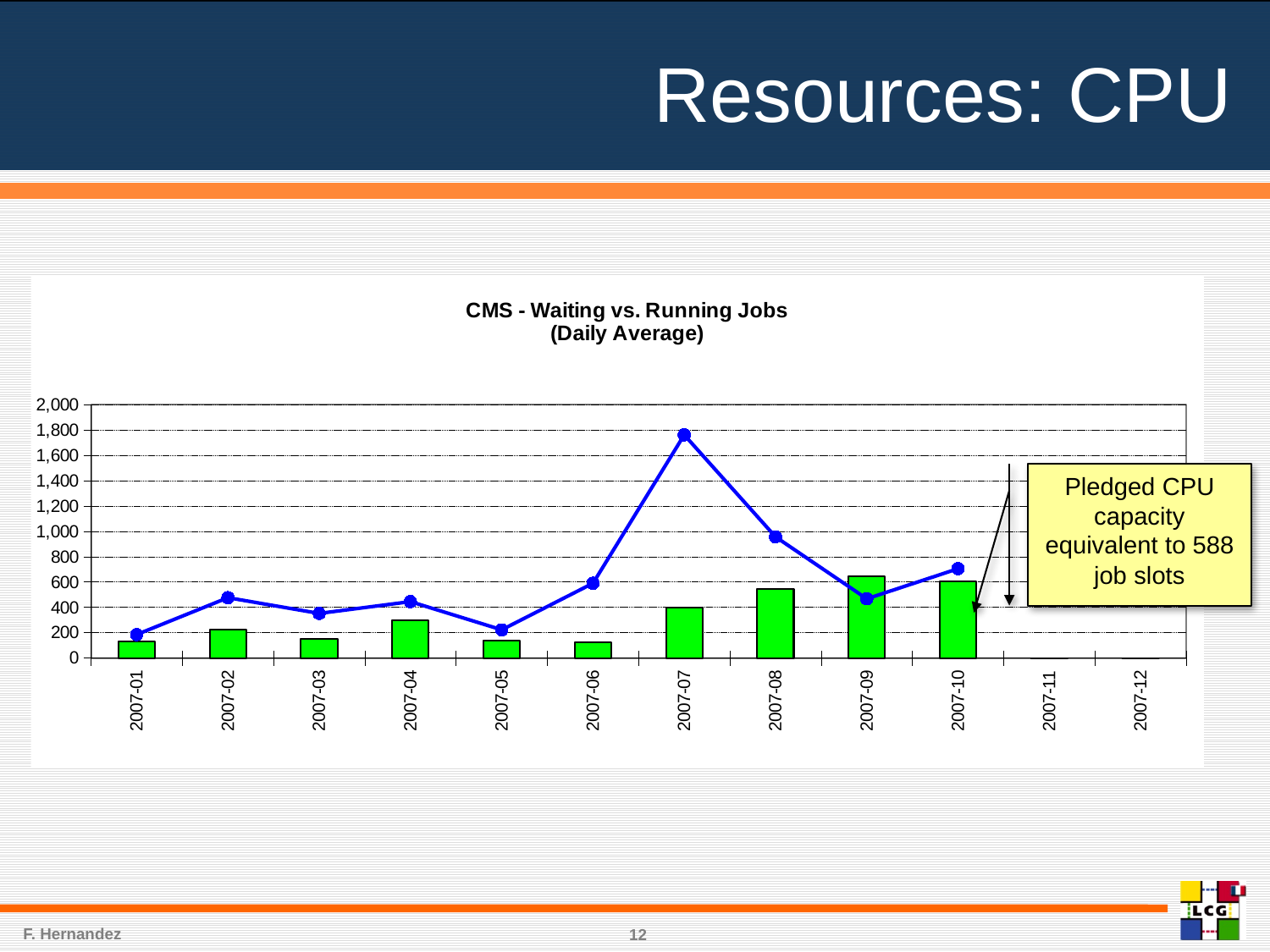
Is the value of the green bar for 2007-06 greater or less than 200? less How many months are shown on the x axis of the chart? 12 Does the blue line rise or fall from 2007-05 to 2007-07? rise According to the annotation on the chart, how many job slots is the pledged CPU capacity equivalent to? 588 In which month does the blue line reach its highest value? 2007-07 Is the value of the green bar for 2007-08 greater or less than 400? greater In which month is the green bar the tallest? 2007-09 What is the title of the chart? CMS - Waiting vs. Running Jobs (Daily Average) What kind of chart is shown on the slide? A combined bar and line chart Is the value of the blue line for 2007-07 greater or less than 1,600? greater Which month has the higher blue line value, 2007-07 or 2007-08? 2007-07